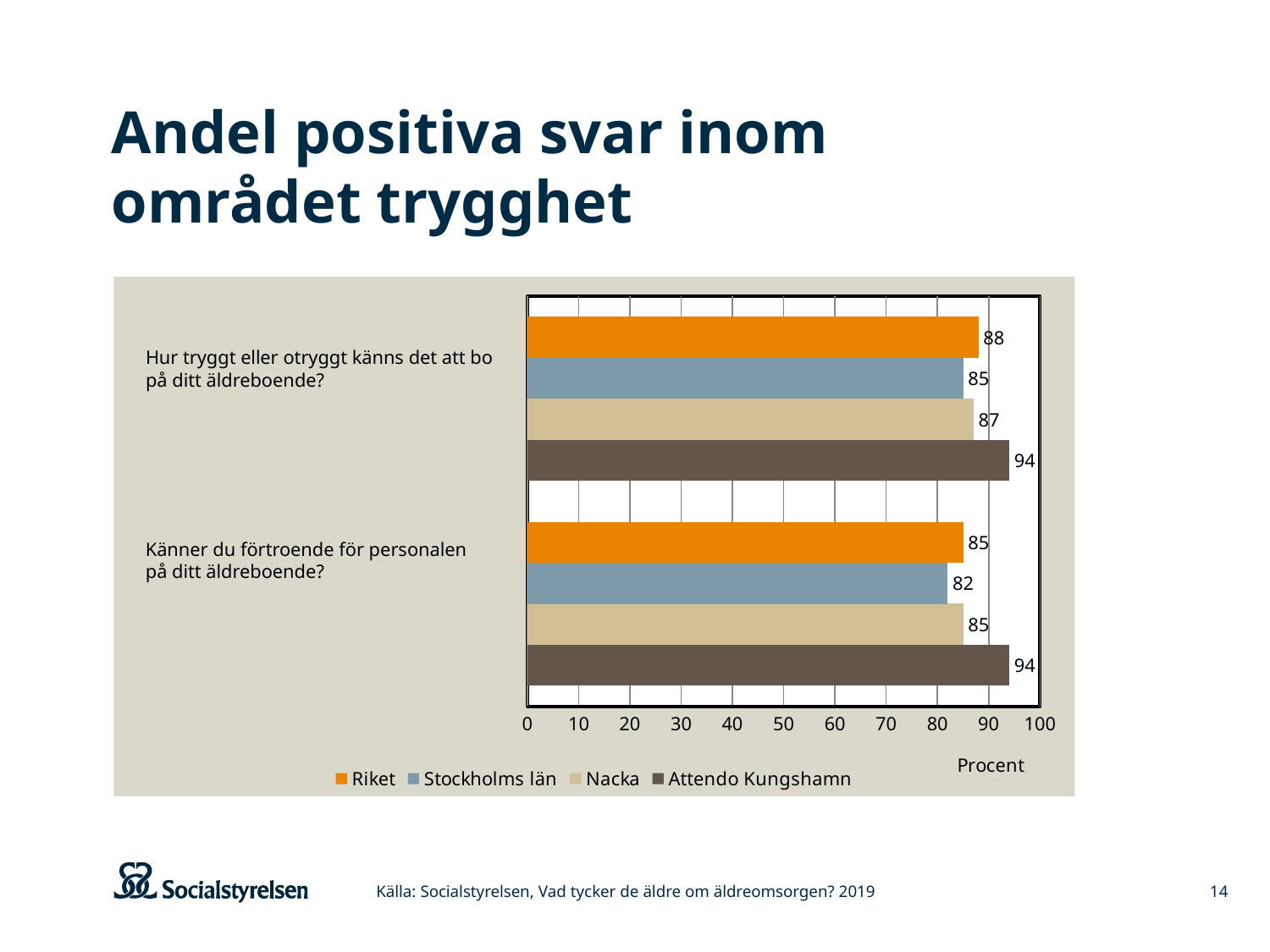
Which series has the highest value for "Känner du förtroende för personalen på ditt äldreboende?"? Attendo Kungshamn How many question categories are shown on the chart? 2 What is the label of the horizontal axis? Procent Which series has the lowest value for "Hur tryggt eller otryggt känns det att bo på ditt äldreboende?"? Stockholms län For "Hur tryggt eller otryggt känns det att bo på ditt äldreboende?", which is larger: the value for Riket or the value for Nacka? Riket What is the difference between the Attendo Kungshamn value and the Stockholms län value for "Känner du förtroende för personalen på ditt äldreboende?"? 12 What is the value for Stockholms län for "Känner du förtroende för personalen på ditt äldreboende?"? 82 What kind of chart is shown on the slide? Bar chart How many series does the legend list? 4 What is the value for Riket for "Hur tryggt eller otryggt känns det att bo på ditt äldreboende?"? 88 What is the value for Nacka for "Känner du förtroende för personalen på ditt äldreboende?"? 85 What is the value for Attendo Kungshamn for "Hur tryggt eller otryggt känns det att bo på ditt äldreboende?"? 94